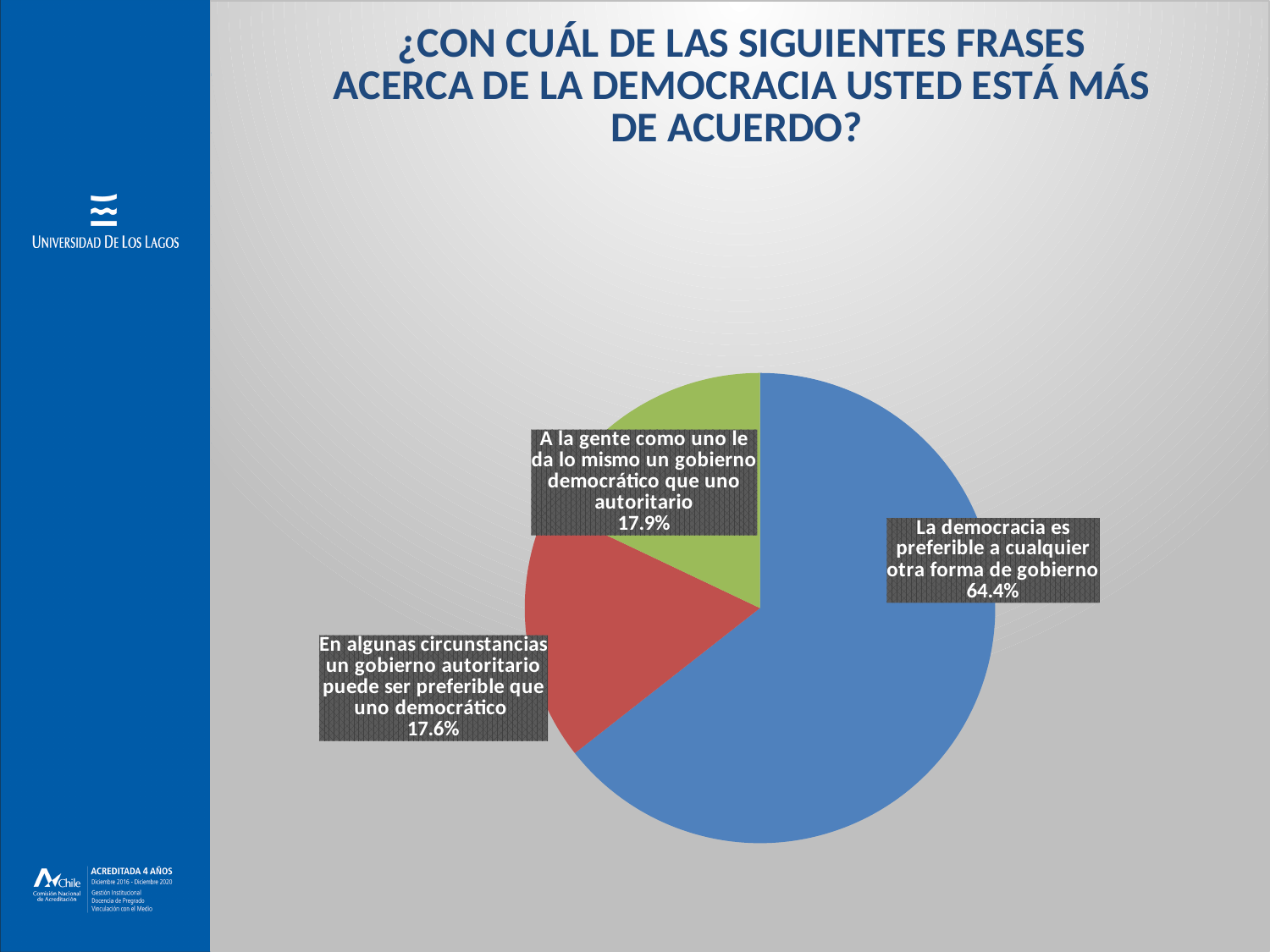
What type of chart is shown on the slide? Pie chart Which response has the largest share of the pie? La democracia es preferible a cualquier otra forma de gobierno What colour is the slice for "La democracia es preferible a cualquier otra forma de gobierno"? Blue Which response has the smallest share of the pie? En algunas circunstancias un gobierno autoritario puede ser preferible que uno democrático What percentage of respondents chose "En algunas circunstancias un gobierno autoritario puede ser preferible que uno democrático"? 17.6% What is the title of the chart on the slide? ¿CON CUÁL DE LAS SIGUIENTES FRASES ACERCA DE LA DEMOCRACIA USTED ESTÁ MÁS DE ACUERDO? What percentage of respondents chose "A la gente como uno le da lo mismo un gobierno democrático que uno autoritario"? 17.9% What is the difference in percentage points between "La democracia es preferible a cualquier otra forma de gobierno" and "En algunas circunstancias un gobierno autoritario puede ser preferible que uno democrático"? 46.8 How many slices does the pie chart have? 3 What is the difference in percentage points between "La democracia es preferible a cualquier otra forma de gobierno" and "A la gente como uno le da lo mismo un gobierno democrático que uno autoritario"? 46.5 What percentage of respondents chose "La democracia es preferible a cualquier otra forma de gobierno"? 64.4% Which is larger according to the printed labels: the share for "A la gente como uno le da lo mismo un gobierno democrático que uno autoritario" or the share for "En algunas circunstancias un gobierno autoritario puede ser preferible que uno democrático"? A la gente como uno le da lo mismo un gobierno democrático que uno autoritario